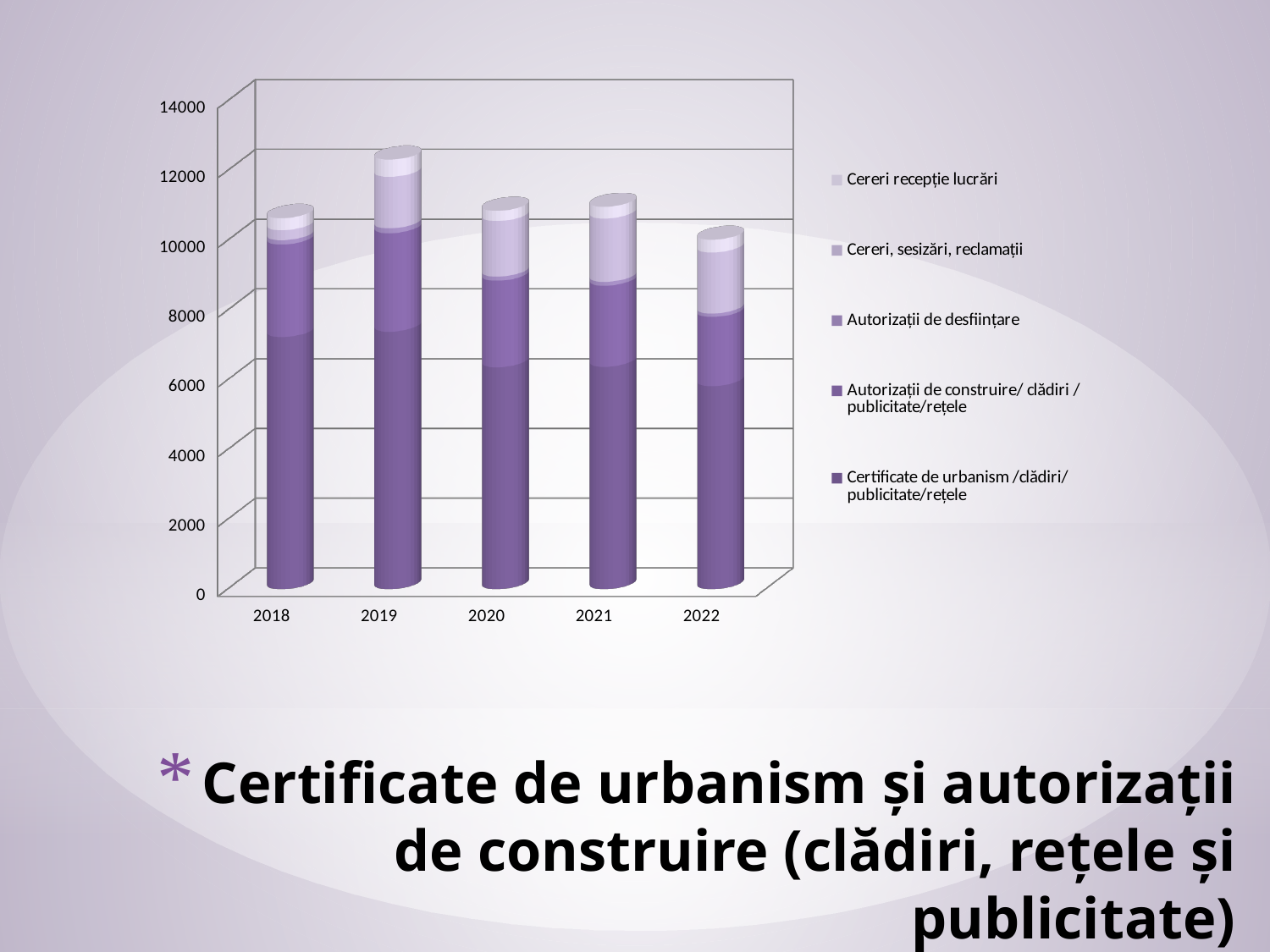
How many series does the chart legend list? 5 Is the total of the stacked bar for 2022 greater or less than 12000? less Which year has the tallest stacked bar overall? 2019 Which year has the larger value for 'Certificate de urbanism /clădiri/ publicitate/rețele', 2019 or 2022? 2019 Which year has the shortest stacked bar overall? 2022 How many years are shown on the x axis of the chart? 5 What kind of chart is shown on the slide? Stacked bar chart From 2019 to 2022, do the stacked bar totals rise or fall? Fall What is the first entry listed in the chart legend? Cereri recepție lucrări Is the total of the stacked bar for 2018 greater or less than 10000? greater Is the total of the stacked bar for 2019 greater or less than 12000? greater